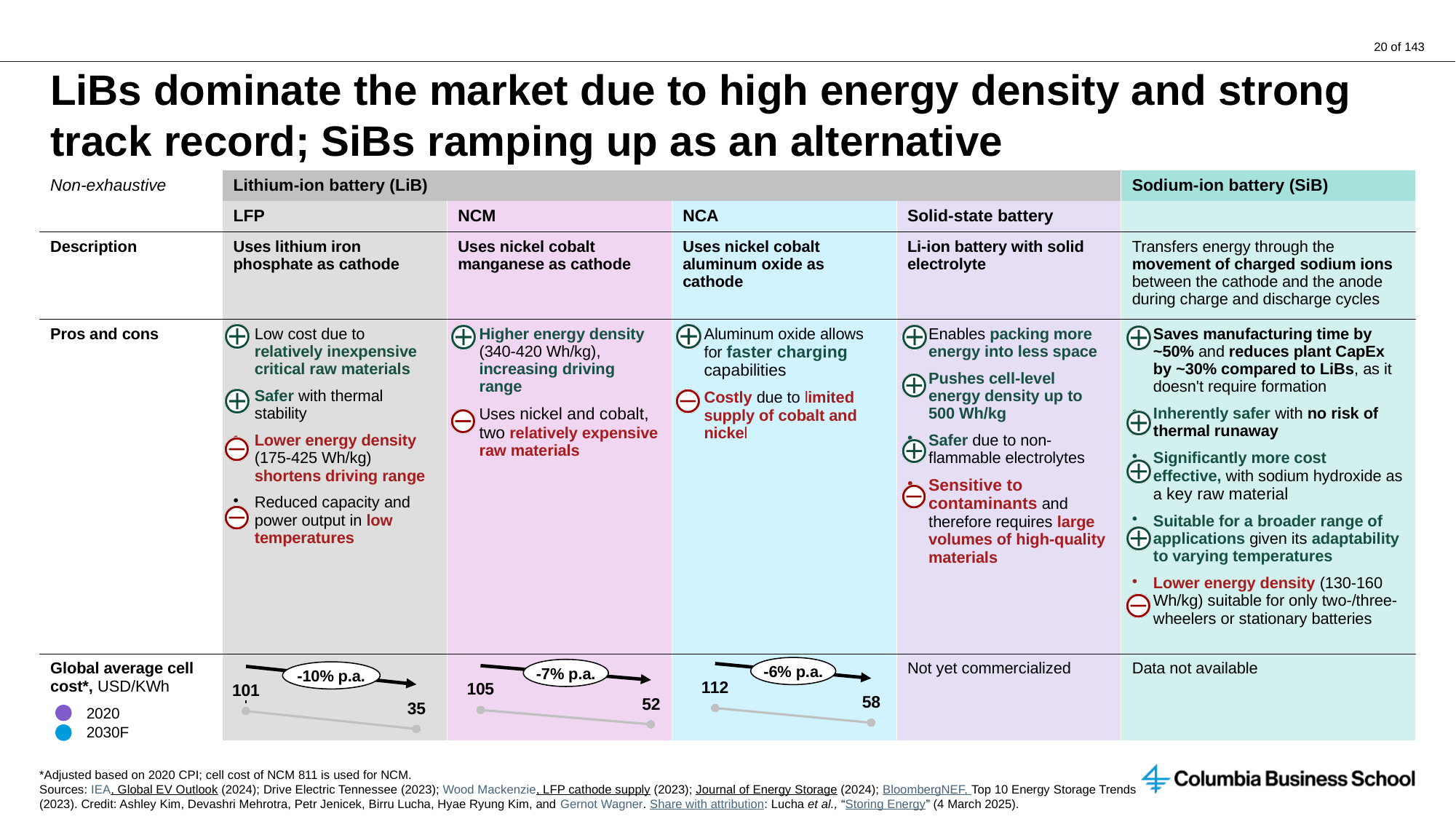
In the Global average cell cost row, what is the 2020 cell cost for LFP in USD/KWh? 101 In the Global average cell cost row, what is the 2030F cell cost for NCM in USD/KWh? 52 How many entries does the legend for the Global average cell cost charts list? 2 In the Global average cell cost row, is the 2030F cell cost higher for NCM or NCA? NCA In the Global average cell cost row, what is the difference between the 2020 and 2030F cell cost for NCM? 53 In the Global average cell cost row, do the cell cost values rise or fall from 2020 to 2030F? fall In the Global average cell cost row, which battery type has the highest 2020 cell cost? NCA In the Global average cell cost row, what is the 2030F cell cost for NCA in USD/KWh? 58 In the Global average cell cost row, what annual rate of change is shown for the LFP cell cost? -10% p.a. In the Global average cell cost row, what is the difference between the 2020 and 2030F cell cost for LFP? 66 In the Global average cell cost row, which battery type has the lowest 2030F cell cost? LFP In the Global average cell cost row, what annual rate of change is shown for the NCA cell cost? -6% p.a.